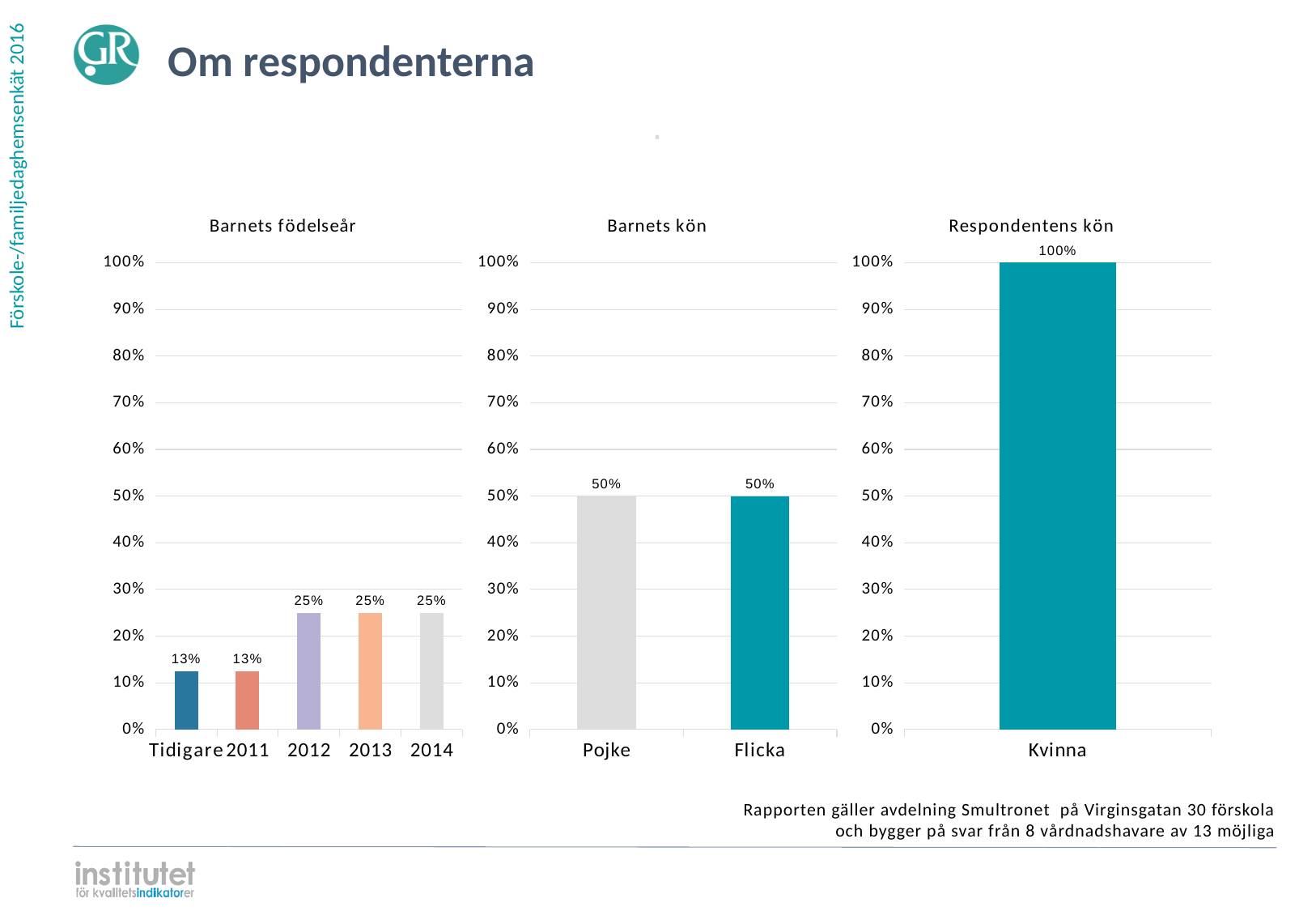
In the 'Barnets kön' chart, what is the value for Pojke? 50% In the 'Barnets födelseår' chart, what is the value for 2012? 25% In the 'Barnets kön' chart, how many categories are shown? 2 In the 'Barnets födelseår' chart, how many categories are shown on the x axis? 5 In the 'Barnets födelseår' chart, is the value for 2012 greater or less than 20%? greater What is the title of the leftmost chart on the slide? Barnets födelseår In the 'Barnets kön' chart, what is the value for Flicka? 50% In the 'Barnets födelseår' chart, what is the difference between the values for 2013 and 2011? 12% In the 'Respondentens kön' chart, what is the value for Kvinna? 100% What kind of chart is the 'Respondentens kön' chart? Bar chart In the 'Barnets födelseår' chart, which is larger, the value for 2014 or the value for 2011? 2014 In the 'Barnets födelseår' chart, what is the value for Tidigare? 13%